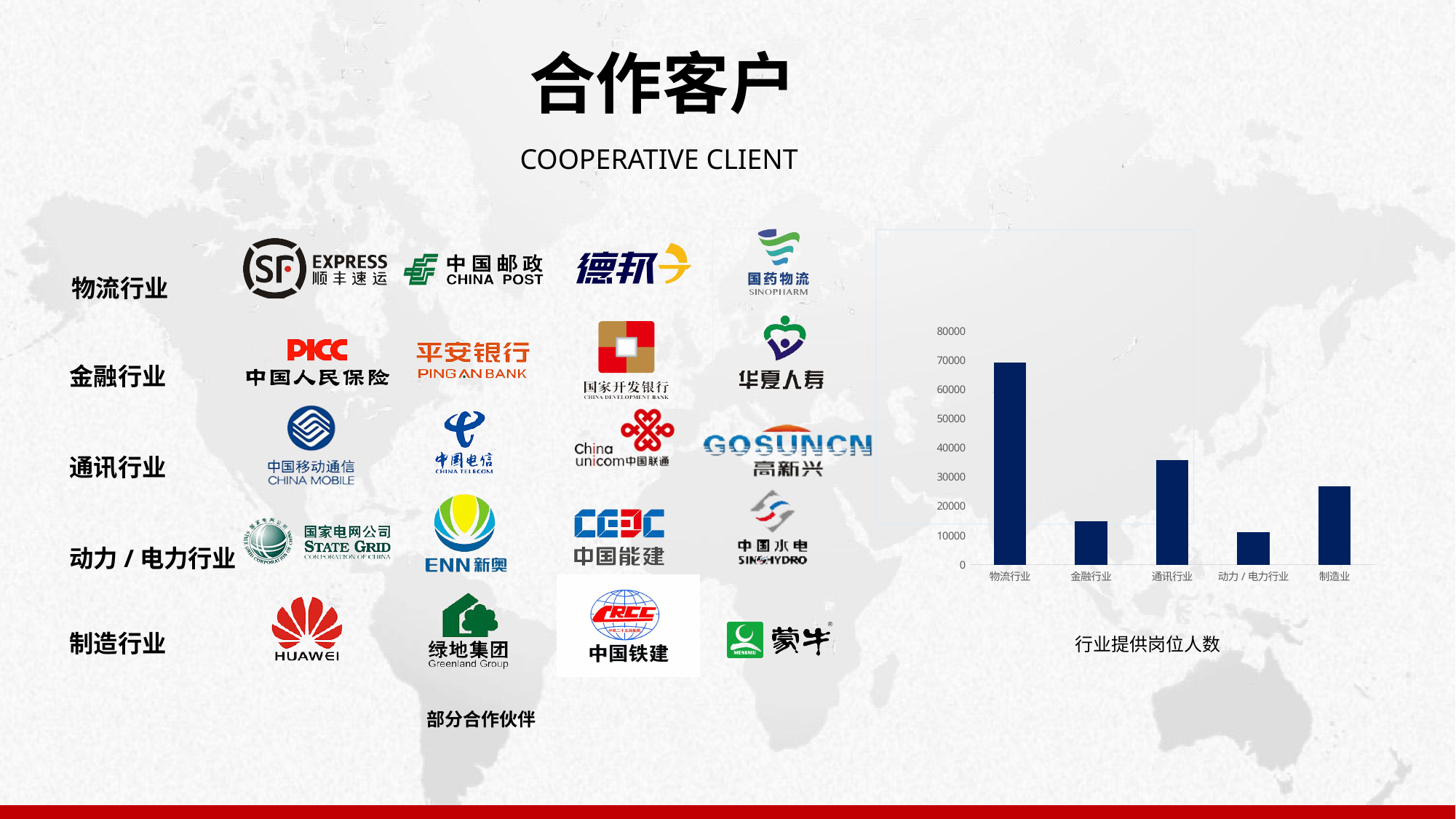
Is the value for 物流行业 greater or less than 60000? greater Which has a larger value, 金融行业 or 动力 / 电力行业? 金融行业 Is the value for 通讯行业 greater or less than 30000? greater Which industry has the lowest bar on the chart? 动力 / 电力行业 What is the caption printed below the chart? 行业提供岗位人数 Is the value for 制造业 greater or less than 30000? less What kind of chart is shown on the slide? bar chart Which industry has the highest bar on the chart? 物流行业 How many industry categories are plotted on the chart? 5 Which has a larger value, 通讯行业 or 制造业? 通讯行业 What is the highest value shown on the chart's vertical axis? 80000